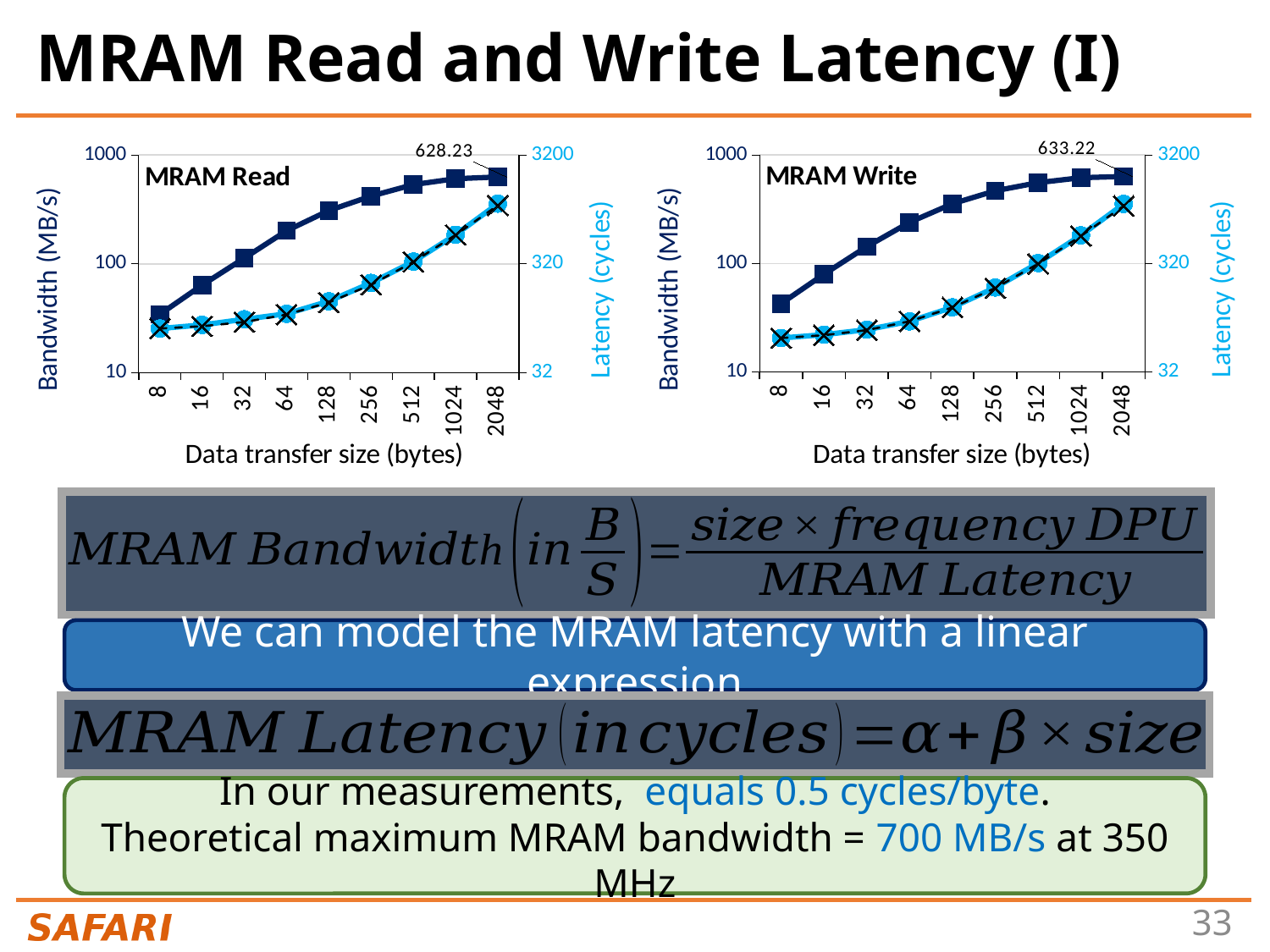
In the MRAM Write chart, is the bandwidth at a data transfer size of 512 bytes greater or less than 100 MB/s? greater Which is larger: the labeled bandwidth at 2048 bytes in the MRAM Write chart or in the MRAM Read chart? MRAM Write In the MRAM Write chart, does the latency rise or fall as the data transfer size increases? Rises How many data transfer sizes are shown on the x axis of the MRAM Read chart? 9 In the MRAM Write chart, at which data transfer size is the bandwidth highest? 2048 In the MRAM Read chart, does the bandwidth rise or fall as the data transfer size increases? Rises What is the difference between the labeled bandwidth at 2048 bytes in the MRAM Write chart (633.22) and in the MRAM Read chart (628.23)? 4.99 In the MRAM Write chart, what is the labeled bandwidth value at a data transfer size of 2048 bytes? 633.22 In the MRAM Read chart, is the bandwidth at a data transfer size of 8 bytes greater or less than 100 MB/s? less In the MRAM Read chart, is the latency at a data transfer size of 2048 bytes greater or less than 320 cycles? greater In the MRAM Read chart, what is the labeled bandwidth value at a data transfer size of 2048 bytes? 628.23 What kind of chart is the MRAM Write chart? Line chart